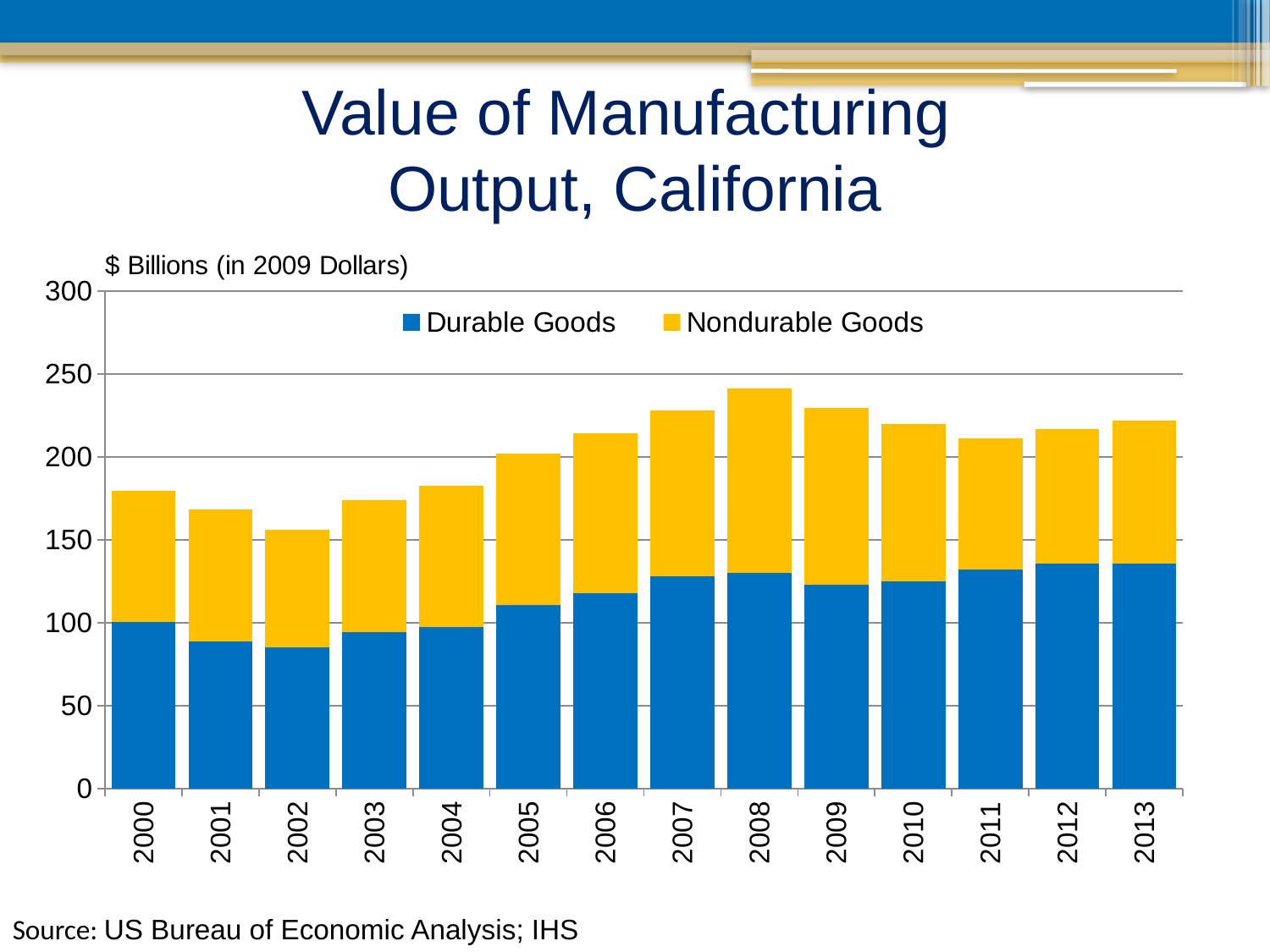
Do total manufacturing output values rise or fall from 2002 to 2008? rise Which year has the highest total manufacturing output? 2008 Which year has the lowest total manufacturing output? 2002 What kind of chart is shown on the slide? Stacked bar chart Is the Durable Goods value for 2002 greater or less than 100? less Is the total manufacturing output for 2002 greater or less than 200? less Is the total manufacturing output for 2008 greater or less than 200? greater What unit label is shown above the vertical axis? $ Billions (in 2009 Dollars) How many years are shown on the x axis? 14 How many series does the legend list? 2 Which year has the larger total manufacturing output, 2003 or 2007? 2007